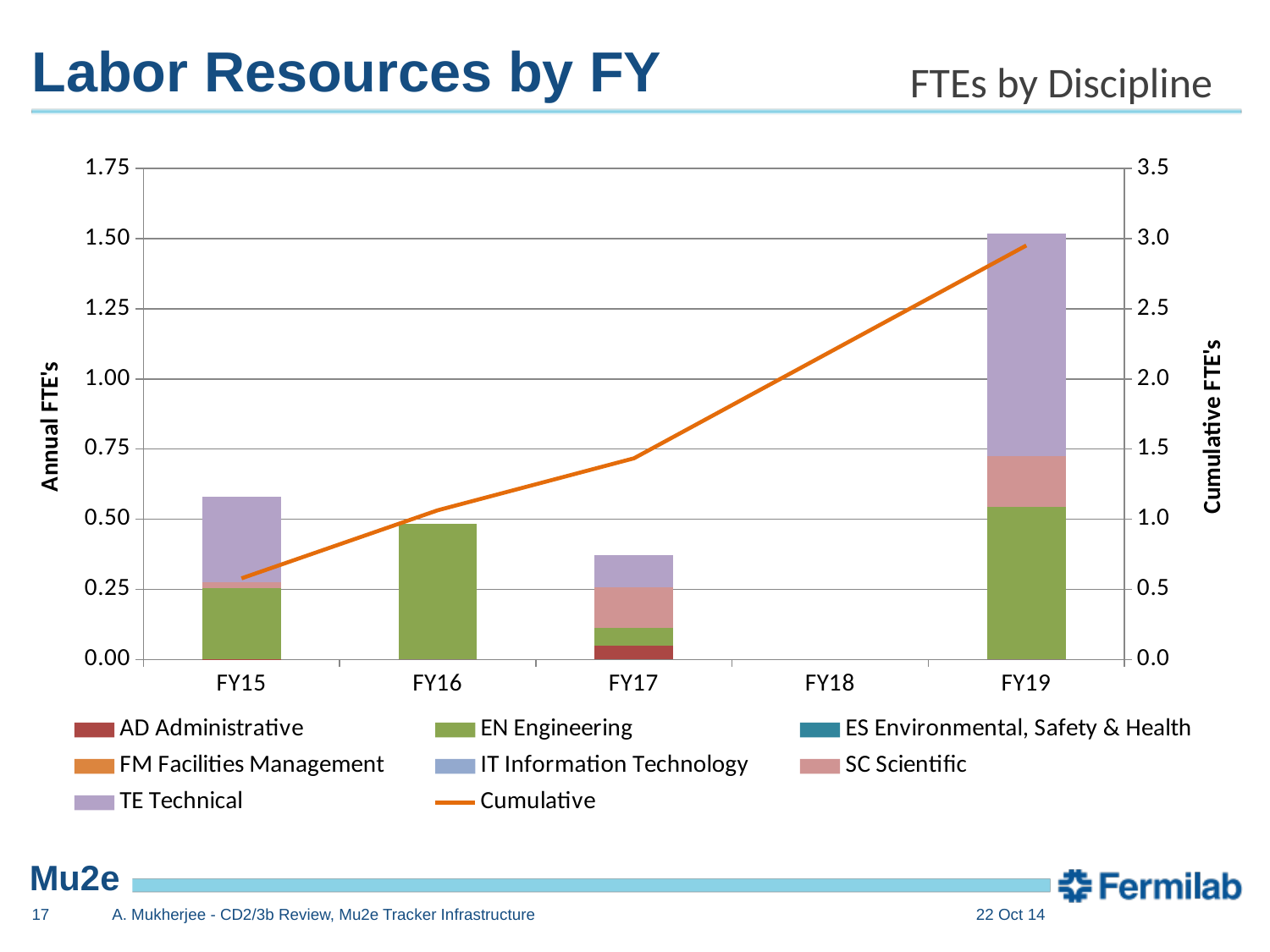
Which fiscal year has the highest total annual FTEs bar? FY19 Which has the larger total annual FTEs bar, FY15 or FY17? FY15 Is the total annual FTEs bar for FY15 greater or less than 0.50? greater What kind of chart is shown on the slide? stacked bar chart with a cumulative line How many series does the legend list? 8 Does the Cumulative line rise or fall from FY15 to FY19? rise Is the total annual FTEs bar for FY19 greater or less than 1.25? greater What is the label of the right-hand vertical axis? Cumulative FTE's Is the Cumulative value at FY19 greater or less than 2.5 on the right axis? greater How many fiscal years are shown on the x axis? 5 Which fiscal year has the lowest total annual FTEs (no visible bar)? FY18